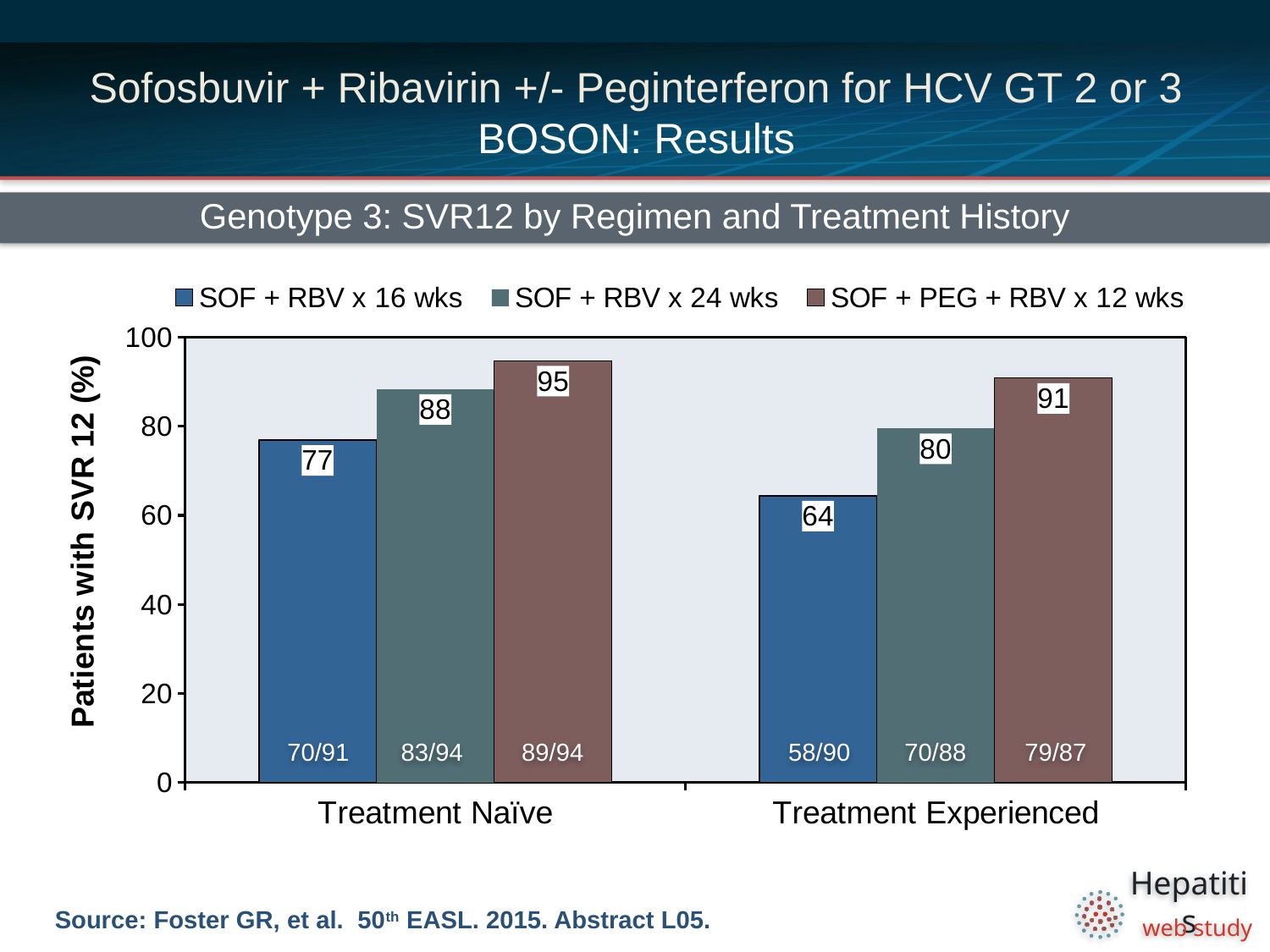
How many treatment history categories are shown on the x axis? 2 Which regimen has the lowest SVR12 rate in the Treatment Experienced group? SOF + RBV x 16 wks What is the SVR12 rate for SOF + RBV x 16 wks in the Treatment Naïve group? 77 How many series does the legend list? 3 What is the difference in SVR12 rate for SOF + RBV x 16 wks between the Treatment Naïve and Treatment Experienced groups? 13 Which regimen has the highest SVR12 rate in the Treatment Naïve group? SOF + PEG + RBV x 12 wks What kind of chart is shown on the slide? Bar chart What is the difference in SVR12 rate between SOF + PEG + RBV x 12 wks and SOF + RBV x 16 wks in the Treatment Naïve group? 18 Which is larger: the SVR12 rate for SOF + RBV x 24 wks in Treatment Naïve patients or in Treatment Experienced patients? Treatment Naïve What is the SVR12 rate for SOF + RBV x 24 wks in the Treatment Experienced group? 80 What is the label of the y axis? Patients with SVR 12 (%) What is the SVR12 rate for SOF + PEG + RBV x 12 wks in the Treatment Experienced group? 91